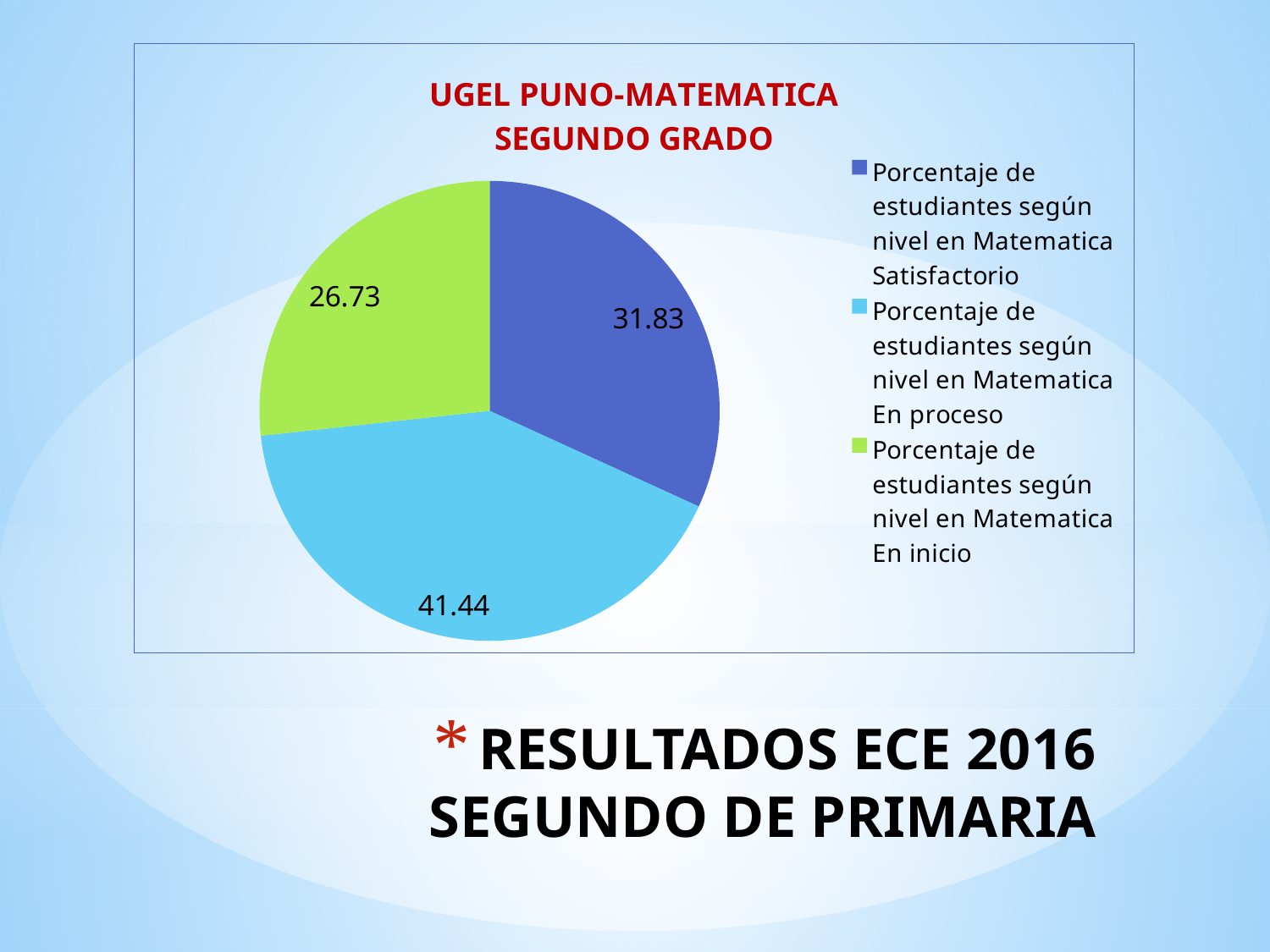
How many entries does the legend list? 3 What is the difference between the En proceso value and the Satisfactorio value? 9.61 What is the value for Porcentaje de estudiantes según nivel en Matematica En inicio? 26.73 What type of chart is shown on the slide? Pie chart What is the value for Porcentaje de estudiantes según nivel en Matematica Satisfactorio? 31.83 What is the difference between the Satisfactorio value and the En inicio value? 5.10 Which level has the smallest slice of the pie? En inicio How many slices does the pie chart have? 3 What is the value for Porcentaje de estudiantes según nivel en Matematica En proceso? 41.44 Which is larger, the value for Satisfactorio or the value for En inicio? Satisfactorio What is the title of the chart? UGEL PUNO-MATEMATICA SEGUNDO GRADO Which level has the largest slice of the pie? En proceso